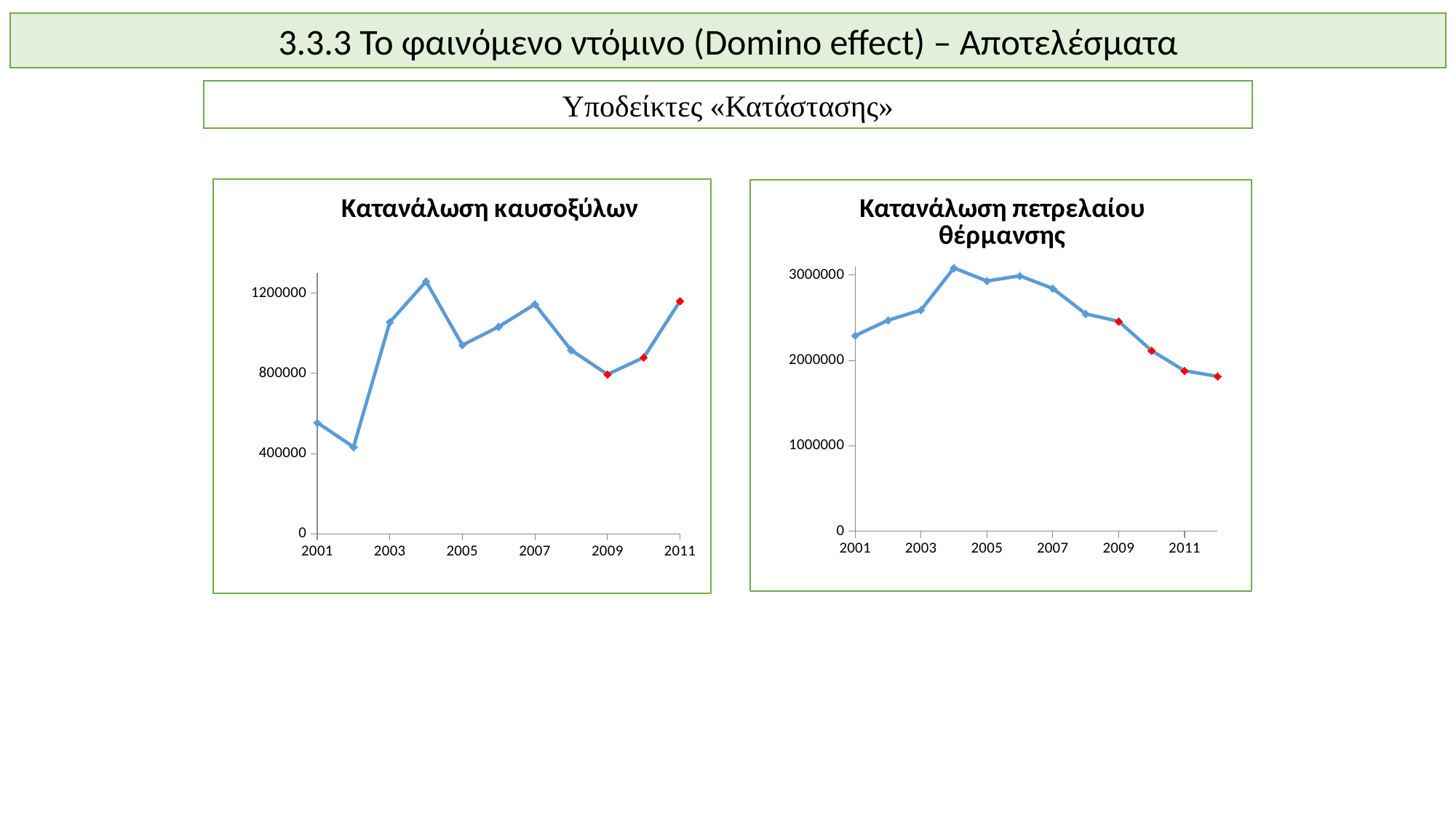
What kind of chart is the 'Κατανάλωση καυσοξύλων' chart? line chart In the 'Κατανάλωση πετρελαίου θέρμανσης' chart, which is larger, the value for 2001 or the value for 2004? 2004 In the 'Κατανάλωση πετρελαίου θέρμανσης' chart, do the values rise or fall from 2006 to 2012? fall In the 'Κατανάλωση πετρελαίου θέρμανσης' chart, is the value for 2004 greater or less than 3000000? greater In the 'Κατανάλωση πετρελαίου θέρμανσης' chart, which year has the highest value? 2004 In the 'Κατανάλωση καυσοξύλων' chart, which year has the lowest value? 2002 In the 'Κατανάλωση καυσοξύλων' chart, which year has the highest value? 2004 In the 'Κατανάλωση καυσοξύλων' chart, is the value for 2003 greater or less than 800000? greater In the 'Κατανάλωση καυσοξύλων' chart, is the value for 2004 greater or less than 1200000? greater In the 'Κατανάλωση καυσοξύλων' chart, do the values rise or fall from 2009 to 2011? rise